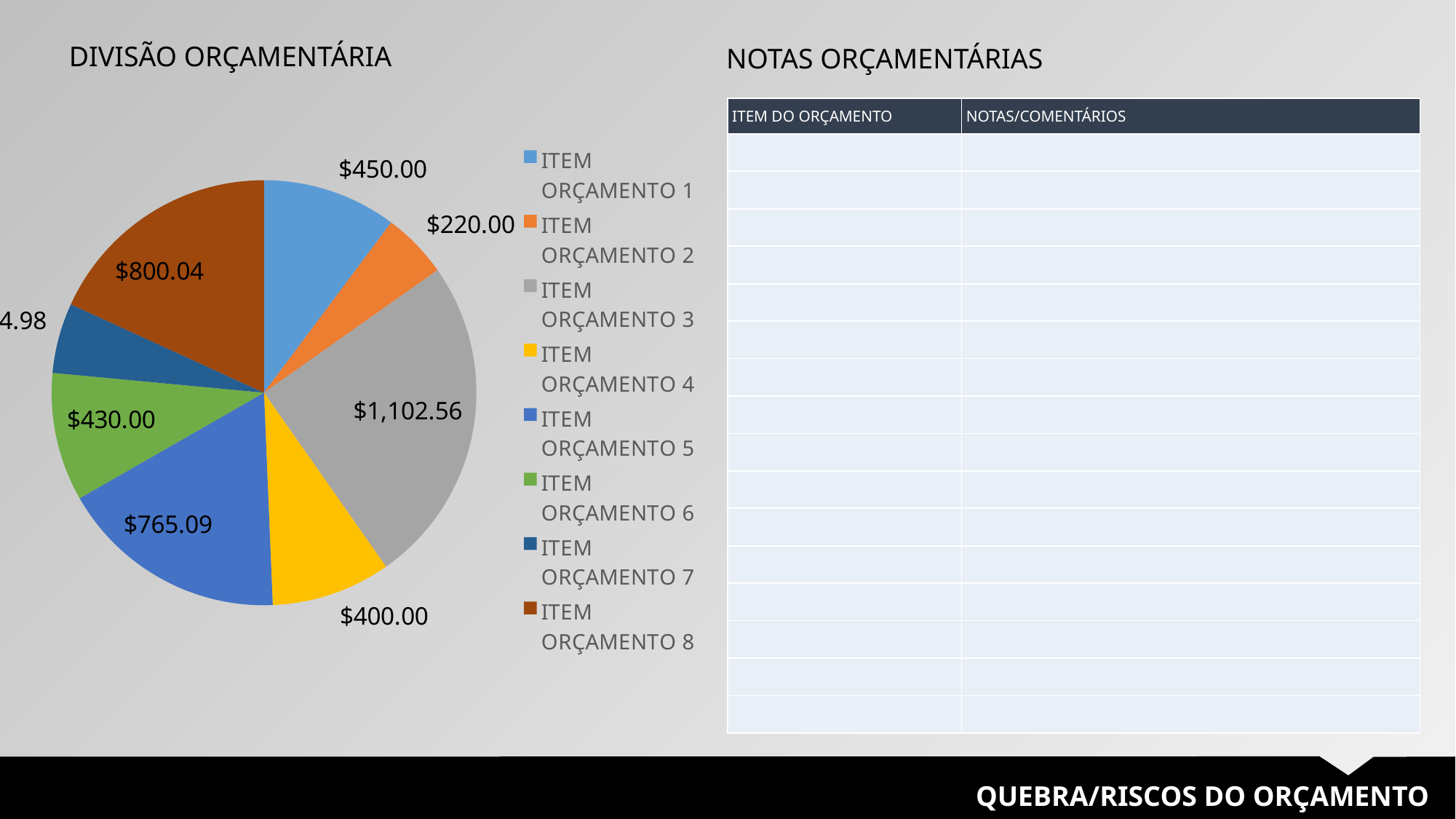
What is the difference between the values for ITEM ORÇAMENTO 1 and ITEM ORÇAMENTO 4 in the pie chart? $50.00 What kind of chart is shown under the title DIVISÃO ORÇAMENTÁRIA? pie chart What is the title of the pie chart on the slide? DIVISÃO ORÇAMENTÁRIA Which item has the largest slice in the pie chart? ITEM ORÇAMENTO 3 What is the value for ITEM ORÇAMENTO 8 in the pie chart? $800.04 What is the difference between the values for ITEM ORÇAMENTO 3 and ITEM ORÇAMENTO 2 in the pie chart? $882.56 What is the value for ITEM ORÇAMENTO 2 in the pie chart? $220.00 How many items does the legend of the pie chart list? 8 What is the value for ITEM ORÇAMENTO 5 in the pie chart? $765.09 Which is larger in the pie chart, ITEM ORÇAMENTO 5 or ITEM ORÇAMENTO 8? ITEM ORÇAMENTO 8 What is the value for ITEM ORÇAMENTO 3 in the pie chart? $1,102.56 What is the value for ITEM ORÇAMENTO 1 in the pie chart? $450.00